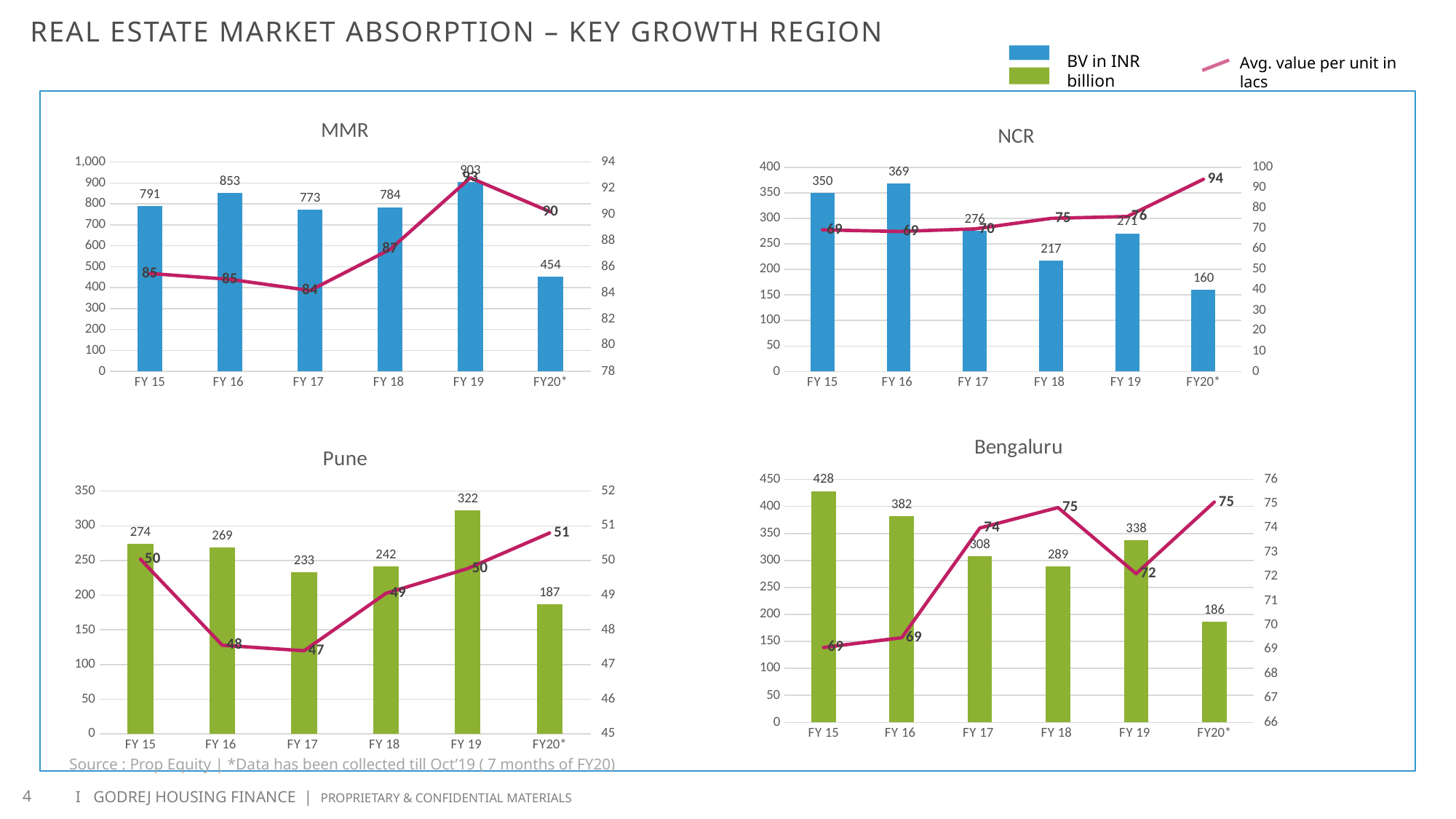
In the MMR chart, is the BV in INR billion for FY20* greater or less than 500? less In the MMR chart, what is the BV in INR billion for FY 19? 903 How many fiscal years are shown on the x axis of the Pune chart? 6 In the Bengaluru chart, is the BV in INR billion larger for FY 15 or FY 16? FY 15 What kind of chart is the NCR chart? Combined bar and line chart In the NCR chart, what is the difference in BV in INR billion between FY 16 and FY 18? 152 In the NCR chart, what is the average value per unit in lacs for FY20*? 94 In the Bengaluru chart, which fiscal year has the lowest BV in INR billion? FY20* In the Pune chart, which fiscal year has the highest BV in INR billion? FY 19 In the Bengaluru chart, what is the average value per unit in lacs for FY 19? 72 How many series does the legend at the top of the slide list? 2 In the Pune chart, does the average value per unit in lacs rise or fall from FY 17 to FY20*? rise